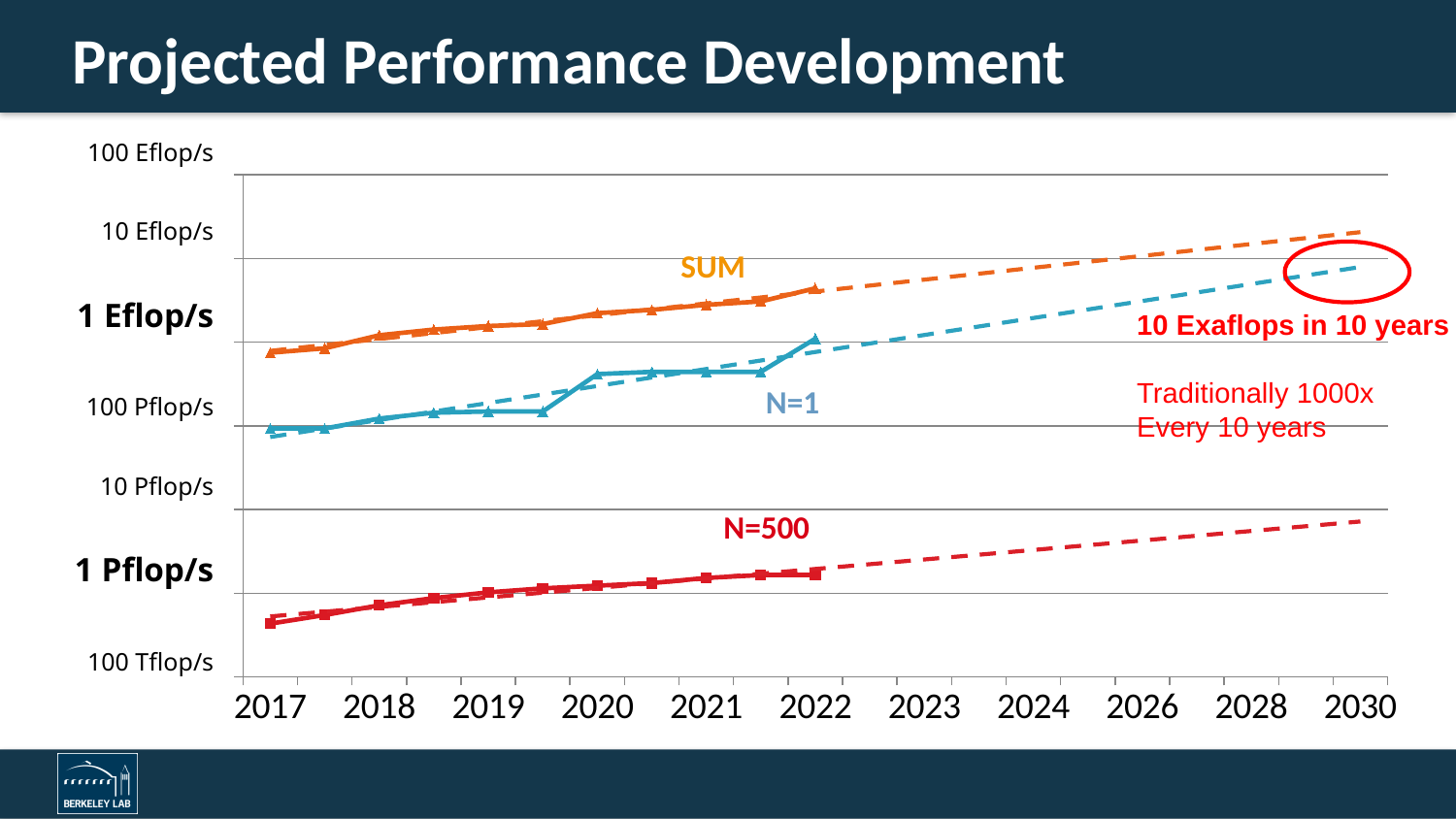
What is the title of the chart on the slide? Projected Performance Development Is the value for N=500 in 2022 greater or less than 1 Pflop/s? greater Which is larger in 2022, the SUM value or the N=1 value? SUM Do the values of the N=500 series rise or fall from 2017 to 2022? rise What does the red annotation next to the circled point say? 10 Exaflops in 10 years What kind of chart is shown on the slide? line chart Which series has the highest values across the chart? SUM How many data series are labelled on the chart? 3 Which series has the lowest values across the chart? N=500 Is the value for SUM in 2022 greater or less than 1 Eflop/s? greater